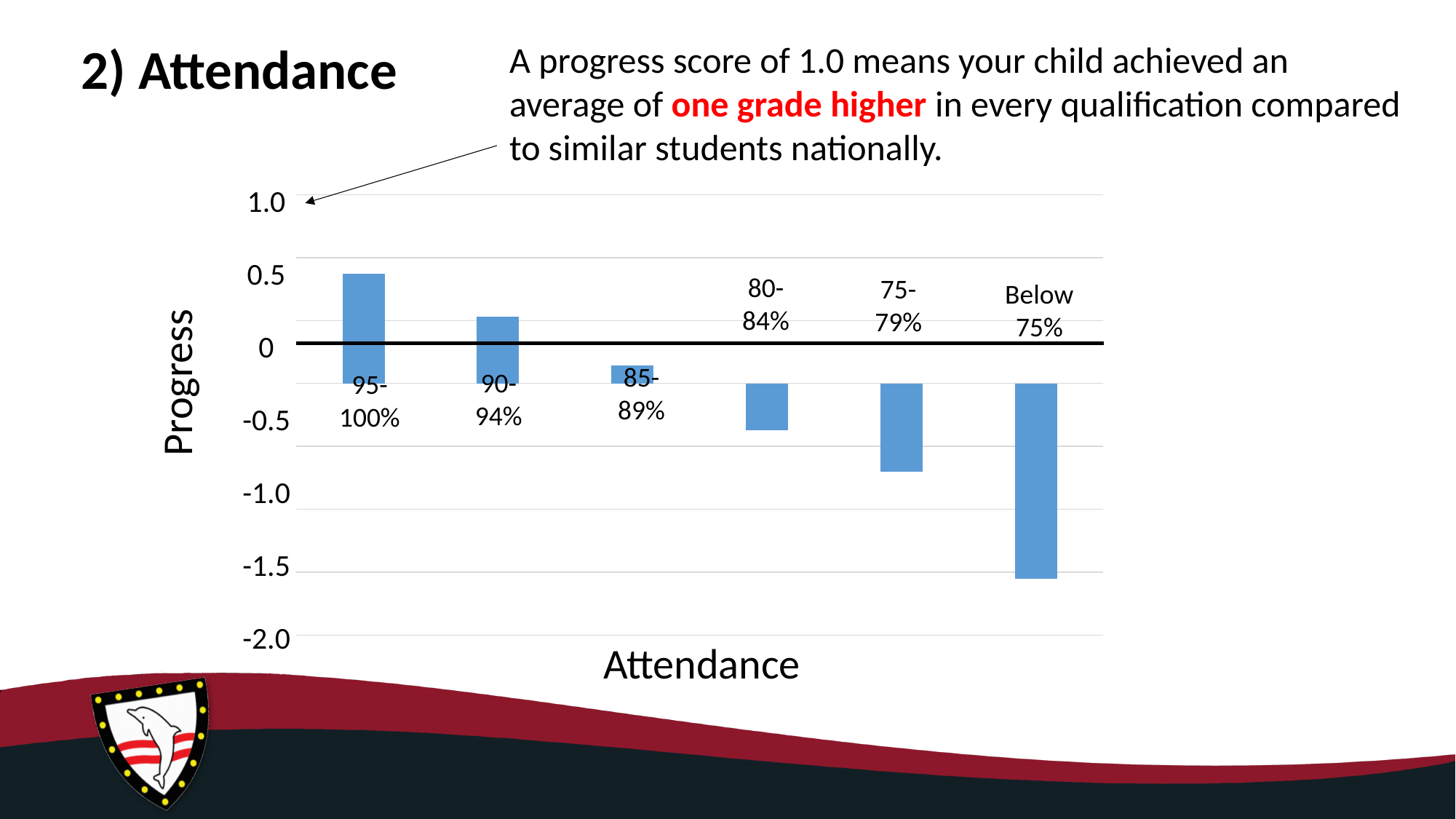
Is the progress score for 75-79% attendance greater or less than -0.5? less Is the progress score for Below 75% attendance greater or less than -1.0? less Do the progress scores rise or fall as attendance decreases from left to right along the x axis? fall How many attendance categories are plotted in the chart? 6 What kind of chart is shown on the slide? bar chart Is the progress score for 90-94% attendance greater or less than 0.5? less Which attendance category has the highest progress score? 95-100% What is the title of the vertical axis of the chart? Progress Which has the higher progress score, 90-94% attendance or 75-79% attendance? 90-94% Which attendance category has the lowest progress score? Below 75%